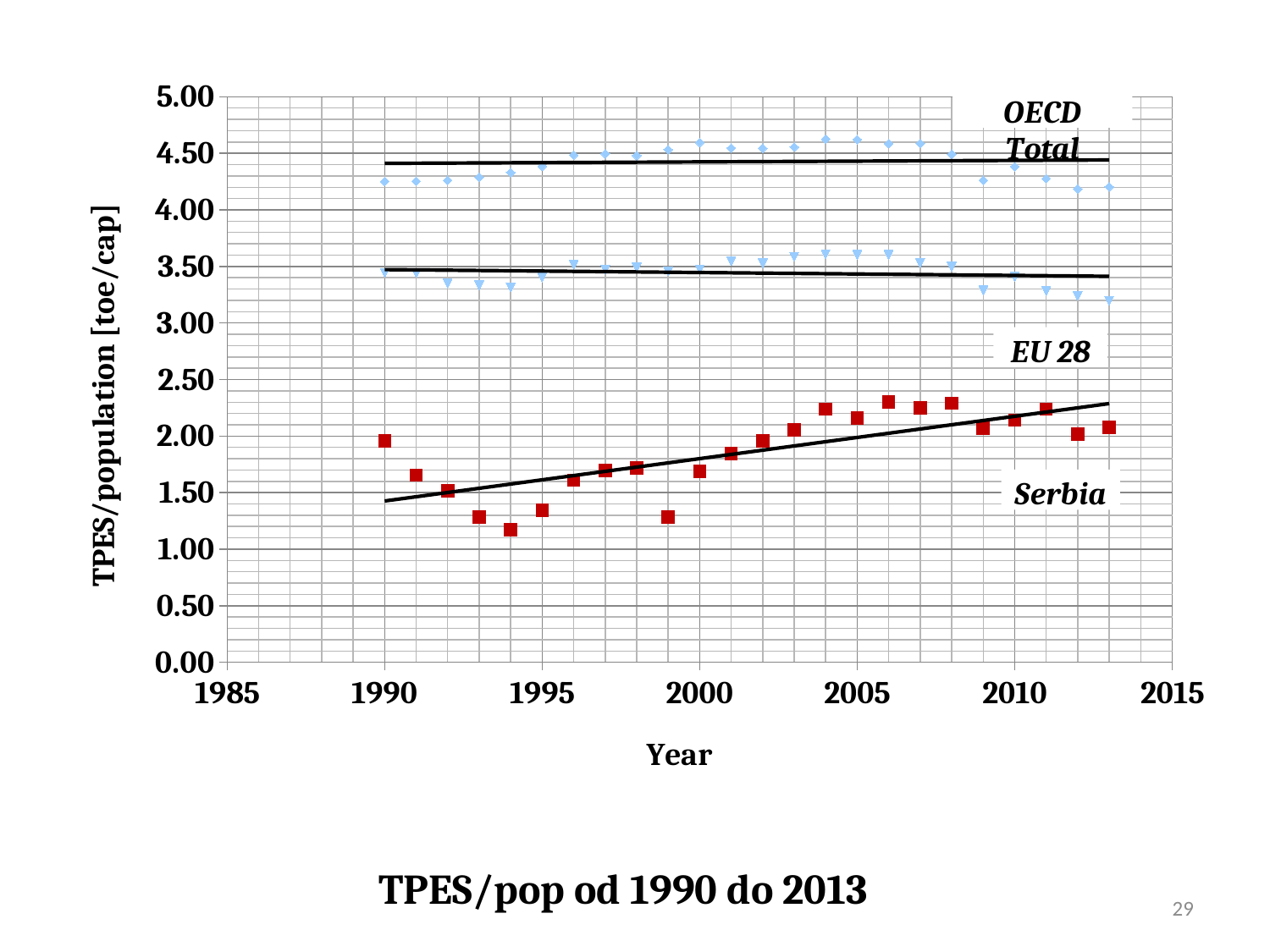
Which series has the highest values throughout the chart? OECD Total Is the value for OECD Total in 2013 greater or less than 4.50? less Is the value for Serbia in 2006 greater or less than 2.00? greater In 2000, which is larger: the value for OECD Total or the value for Serbia? OECD Total How many data series are labelled on the chart? 3 What is the label of the vertical axis? TPES/population [toe/cap] Which series has the lowest values throughout the chart? Serbia Is the value for EU 28 in 2013 greater or less than 3.50? less What kind of chart is shown on the slide? scatter chart Does the trend line for Serbia rise or fall from 1990 to 2013? rise In which year does Serbia have its lowest value? 1994